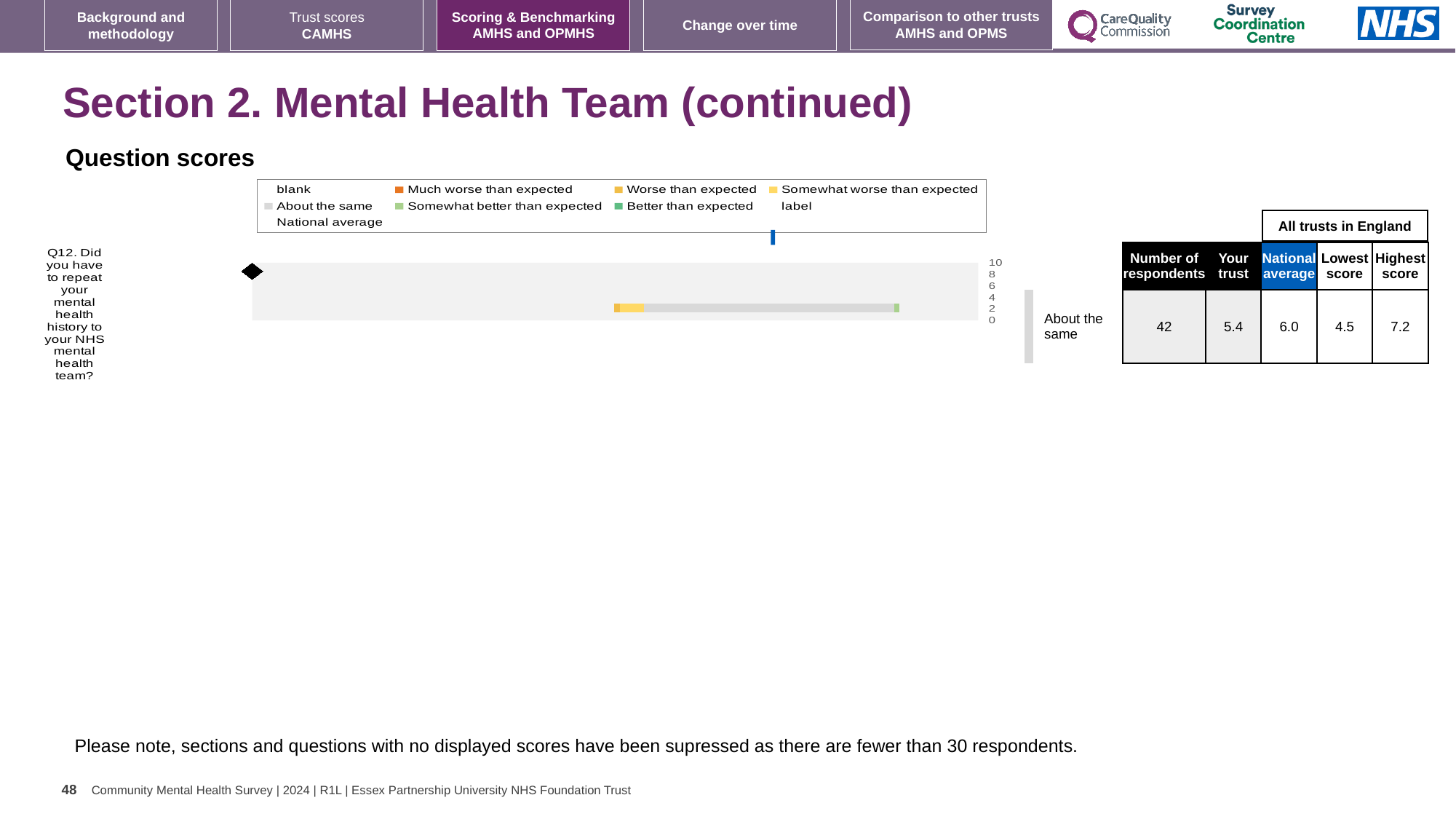
In the table beside the chart, what is the highest score among all trusts in England for Q12? 7.2 What kind of chart is used to show the Q12 question score? bar chart For Q12, what is the difference between the highest score and the lowest score among all trusts in England? 2.7 In the table beside the chart, how many respondents answered Q12? 42 What benchmark category is shown next to the bar for Q12? About the same How many questions are plotted in the Question scores chart? 1 Which legend entry in the Question scores chart is shown in orange? Much worse than expected In the table beside the chart, what is the 'Your trust' score for Q12? 5.4 In the table beside the chart, what is the national average score for Q12? 6.0 For Q12, which is larger: the 'Your trust' score or the national average? national average Which legend entry in the Question scores chart is shown in grey? About the same In the table beside the chart, what is the lowest score among all trusts in England for Q12? 4.5